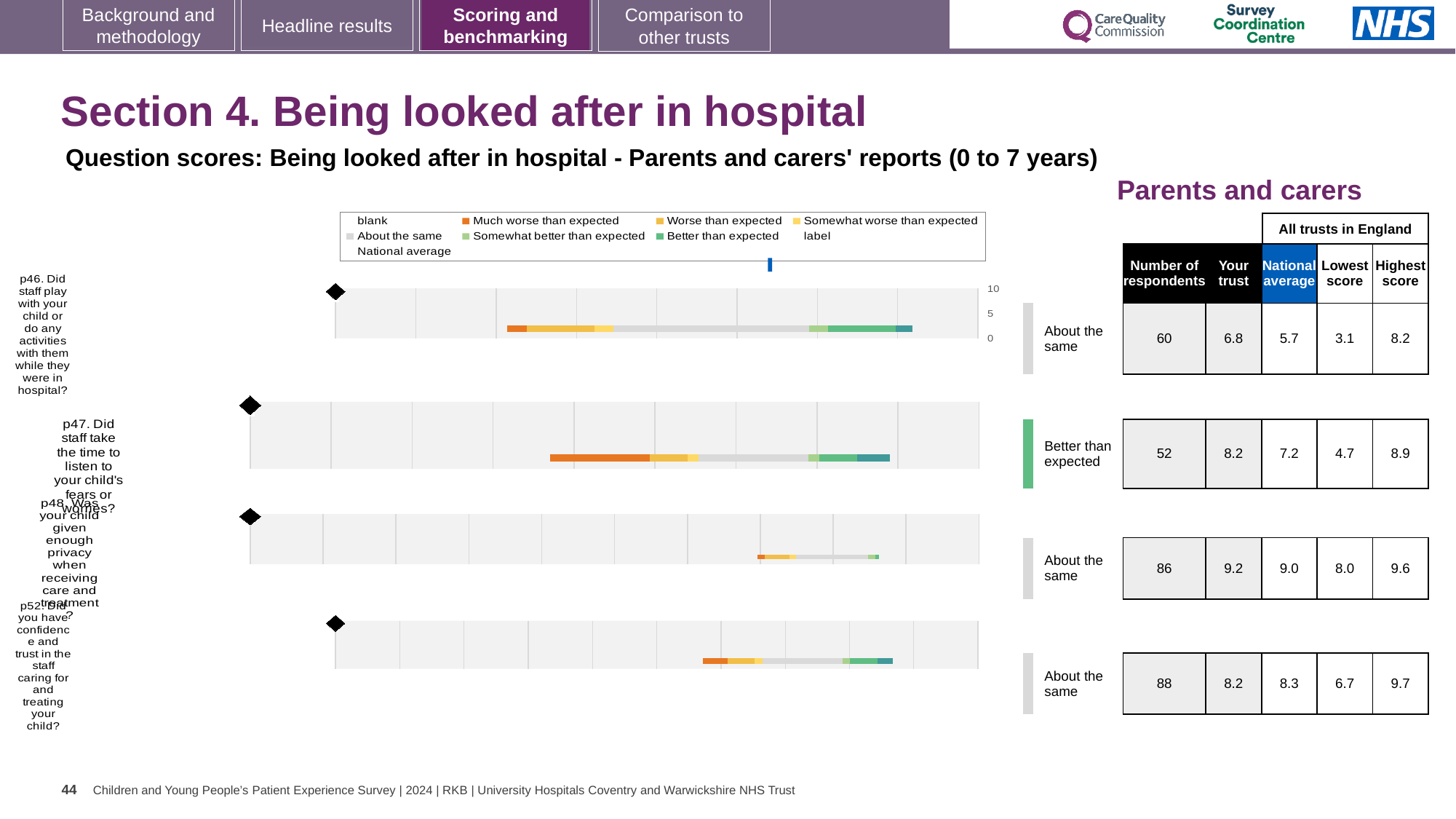
For p52, which is larger: the 'Your trust' score or the national average? National average In the legend, what colour represents 'Much worse than expected'? orange In the table, what is the 'Your trust' score for p46 (Did staff play with your child or do any activities with them while they were in hospital?)? 6.8 Which question has the highest 'Your trust' score in the table? p48 What is the maximum value shown on the chart's score axis? 10 What kind of chart is used to show the question scores on this slide? bar chart In the table, what is the national average for p47 (Did staff take the time to listen to your child's fears or worries?)? 7.2 Which question has the lowest 'Your trust' score in the table? p46 What is the difference between the 'Your trust' score and the national average for p48? 0.2 In the table, how many respondents answered p48 (Was your child given enough privacy when receiving care and treatment?)? 86 How many questions (bars) are plotted in the chart? 4 In the table, what is the highest score across all trusts in England for p52 (Did you have confidence and trust in the staff caring for and treating your child?)? 9.7